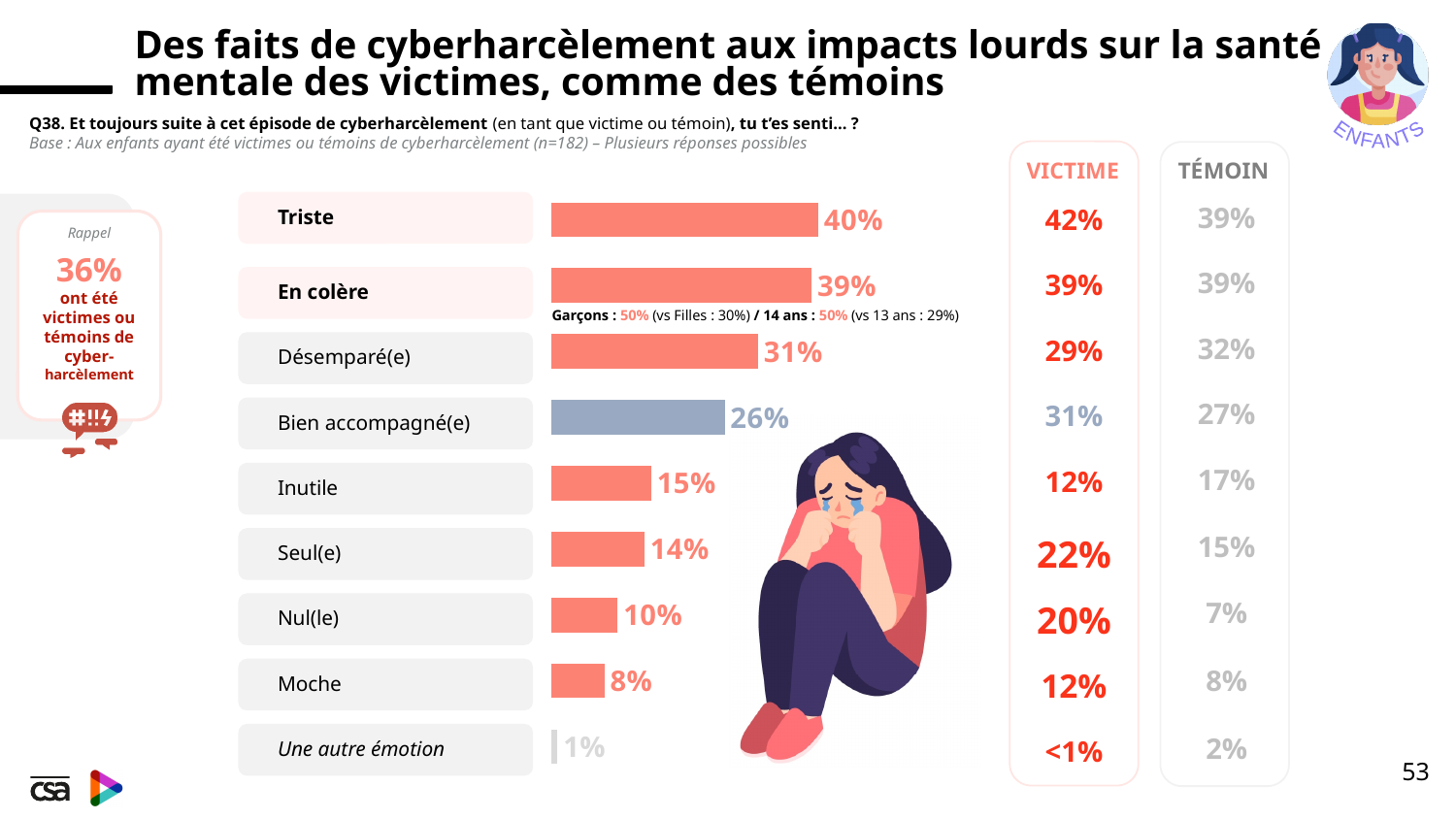
Which bar in the chart is coloured differently (blue-grey) from the others? Bien accompagné(e) What is the difference between the VICTIME and TÉMOIN values for "Nul(le)"? 13% What type of chart is used to show the emotions? Bar chart In the VICTIME column, what percentage is shown for "Seul(e)"? 22% Which is larger, the value for "Seul(e)" or the value for "Nul(le)"? Seul(e) In the TÉMOIN column, what percentage is shown for "Nul(le)"? 7% Which emotion has the lowest percentage in the bar chart? Une autre émotion What is the value shown for "Bien accompagné(e)"? 26% How many emotion categories are shown in the bar chart? 9 Which emotion has the highest percentage in the bar chart? Triste What is the difference between the percentages for "Désemparé(e)" and "Inutile"? 16% What percentage of respondents said they felt "Triste"? 40%